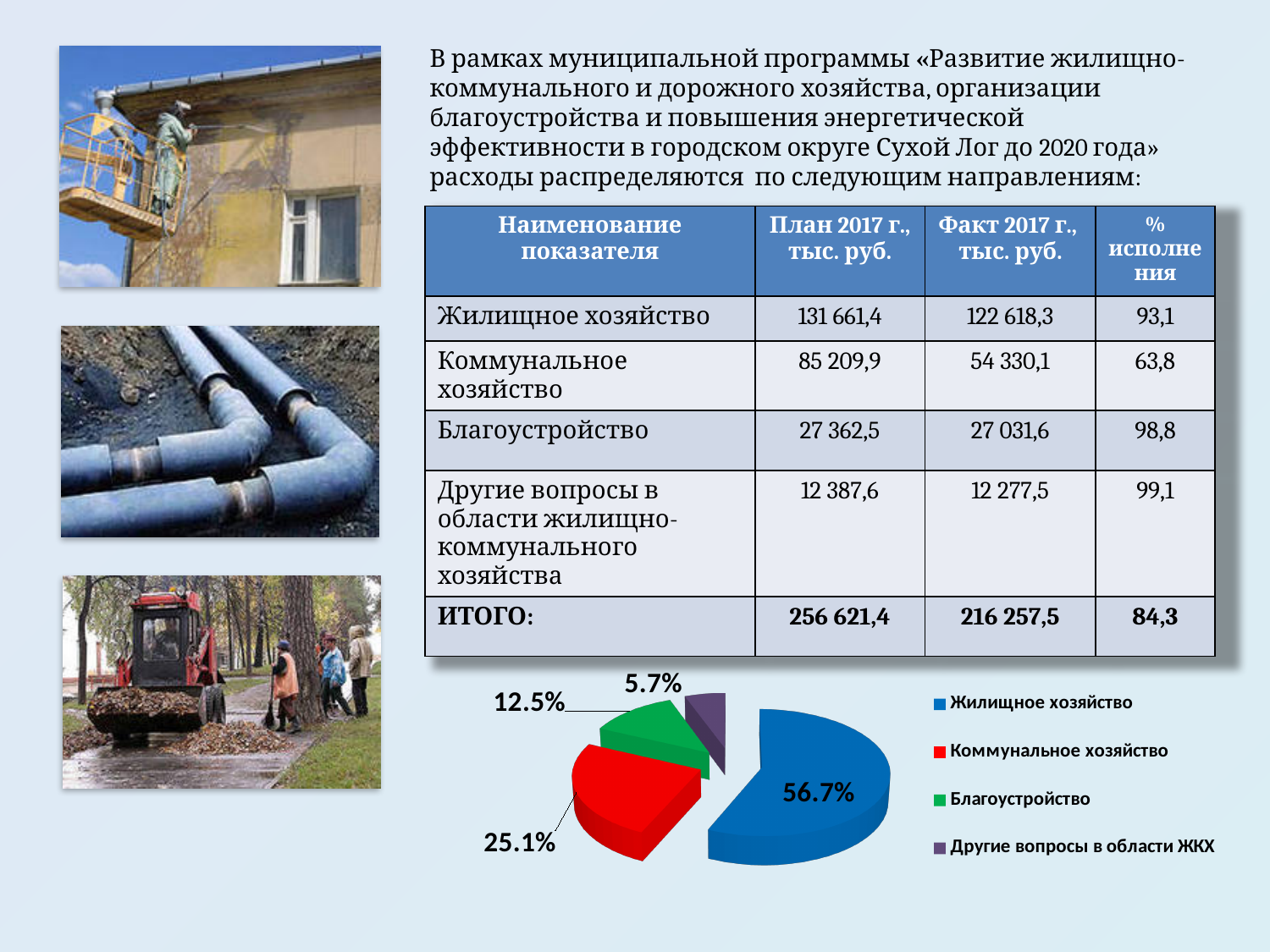
How many entries does the pie chart's legend list? 4 What colour is the Благоустройство slice in the pie chart? green How many slices does the pie chart have? 4 What share of the pie chart does Жилищное хозяйство take? 56.7% Which category has the smallest slice in the pie chart? Другие вопросы в области ЖКХ In the pie chart, what is the difference in percentage points between Жилищное хозяйство and Коммунальное хозяйство? 31.6 Which category has the largest slice in the pie chart? Жилищное хозяйство In the pie chart, which is larger: Коммунальное хозяйство or Благоустройство? Коммунальное хозяйство What share of the pie chart does Другие вопросы в области ЖКХ take? 5.7% What kind of chart is shown at the bottom of the slide? pie chart What share of the pie chart does Коммунальное хозяйство take? 25.1%